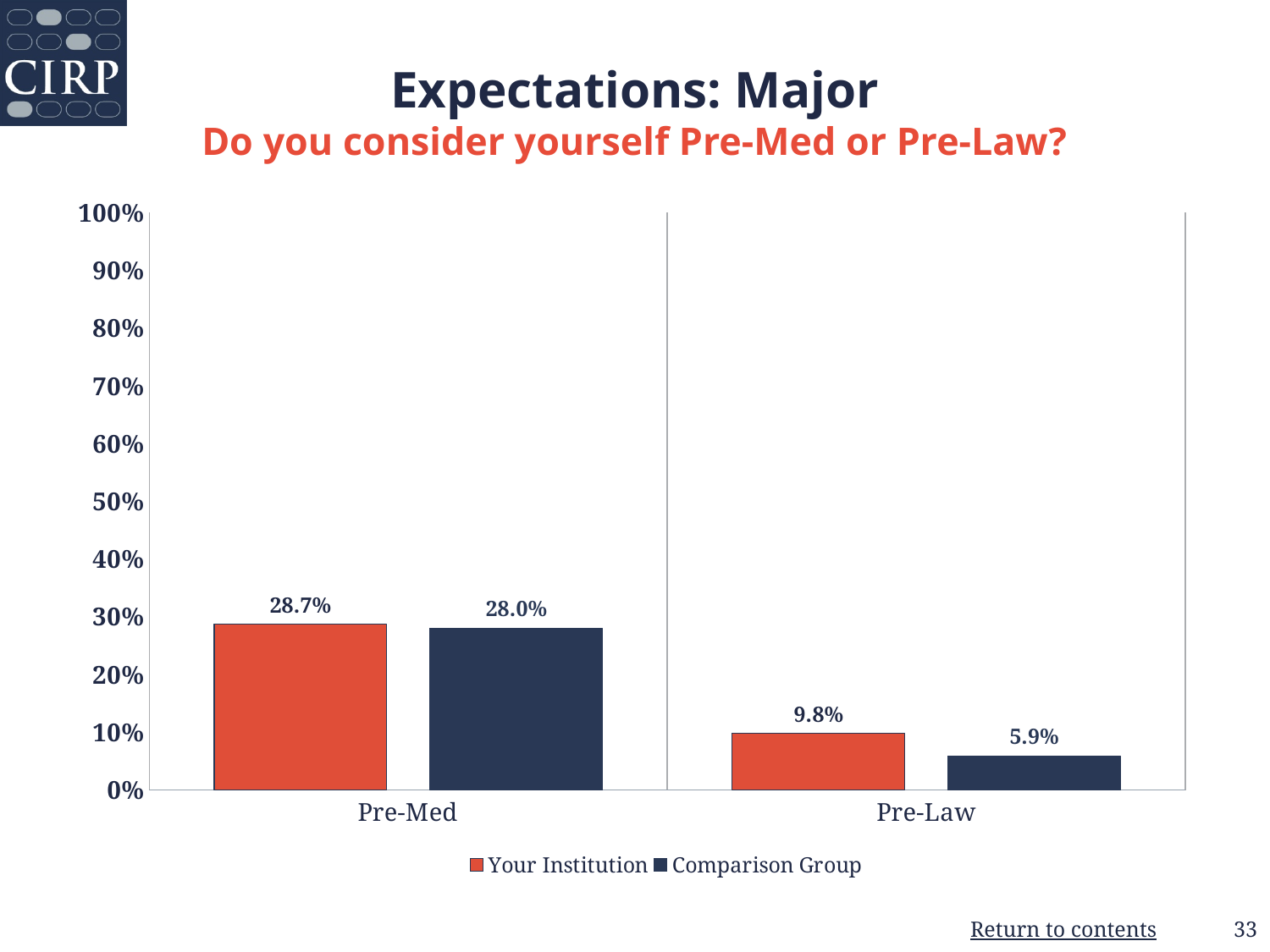
Which category has the lowest value for the Comparison Group? Pre-Law How many categories are shown on the x axis? 2 Which category has the highest value for Your Institution? Pre-Med For Pre-Law, which is larger: Your Institution or the Comparison Group? Your Institution What is the difference between Your Institution and the Comparison Group for Pre-Law? 3.9% What is the Comparison Group value for Pre-Med? 28.0% What percentage of Your Institution students consider themselves Pre-Med? 28.7% What kind of chart is shown on the slide? Bar chart What is the difference between Your Institution and the Comparison Group for Pre-Med? 0.7% What is the Your Institution value for Pre-Law? 9.8% How many series does the legend list? 2 What is the Comparison Group value for Pre-Law? 5.9%